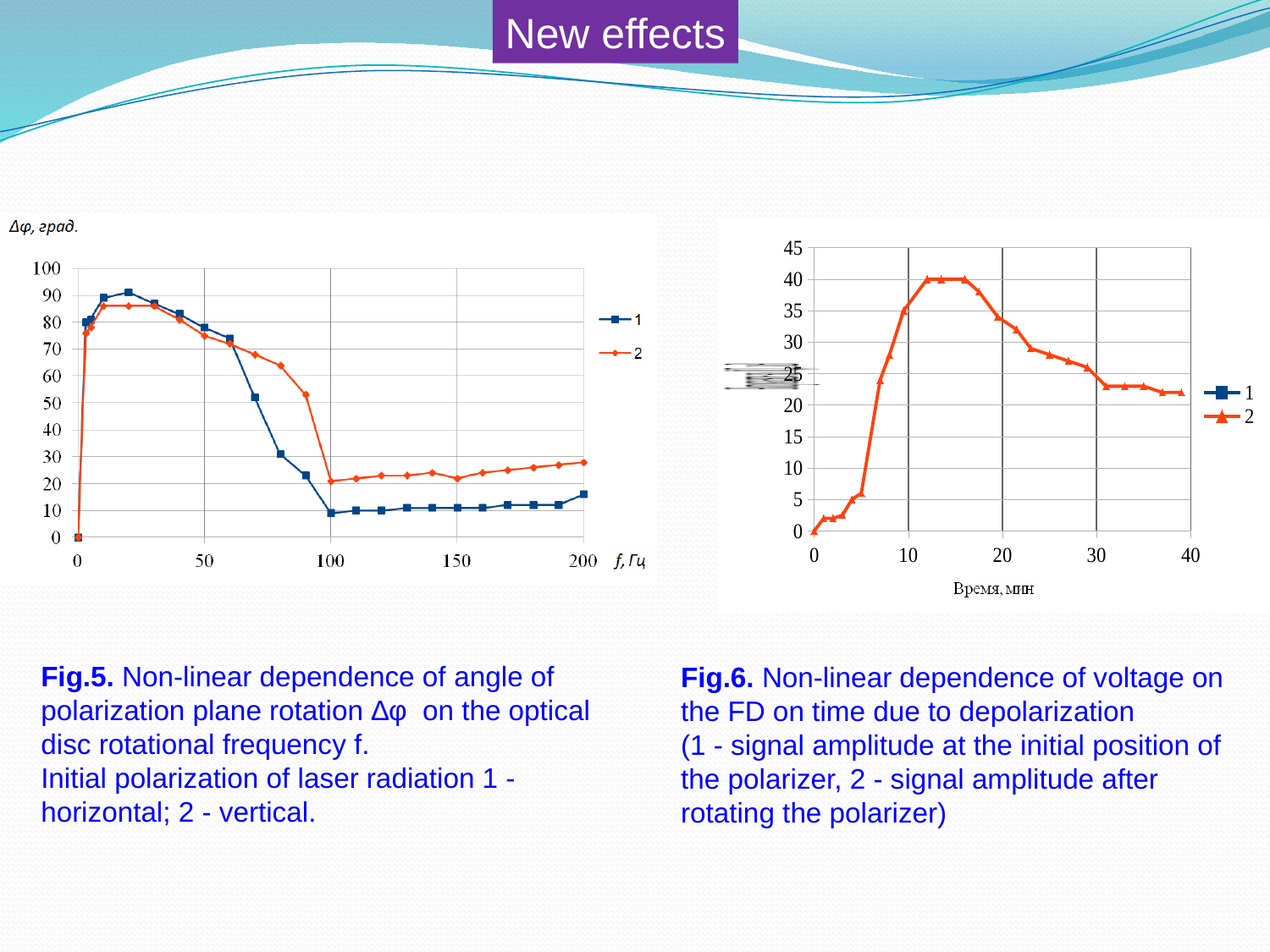
In Fig.5, do the values of series 1 rise or fall between f = 50 Гц and f = 100 Гц? fall In Fig.6, is the value of series 2 at 20 min greater or less than 30? greater In Fig.5, is the value of series 2 at f = 80 Гц greater or less than 60? greater In Fig.6, do the values of series 2 rise or fall between 20 min and 40 min? fall What kind of chart is Fig.6 on the right of the slide? line chart In Fig.5, at f = 80 Гц, which series has the larger value, 1 or 2? 2 In Fig.5, how many series does the legend list? 2 In Fig.5, at f = 200 Гц, which series has the larger value, 1 or 2? 2 In Fig.5, is the value of series 1 at f = 90 Гц greater or less than 20? greater In Fig.6, how many series does the legend list? 2 What kind of chart is Fig.5 on the left of the slide? line chart